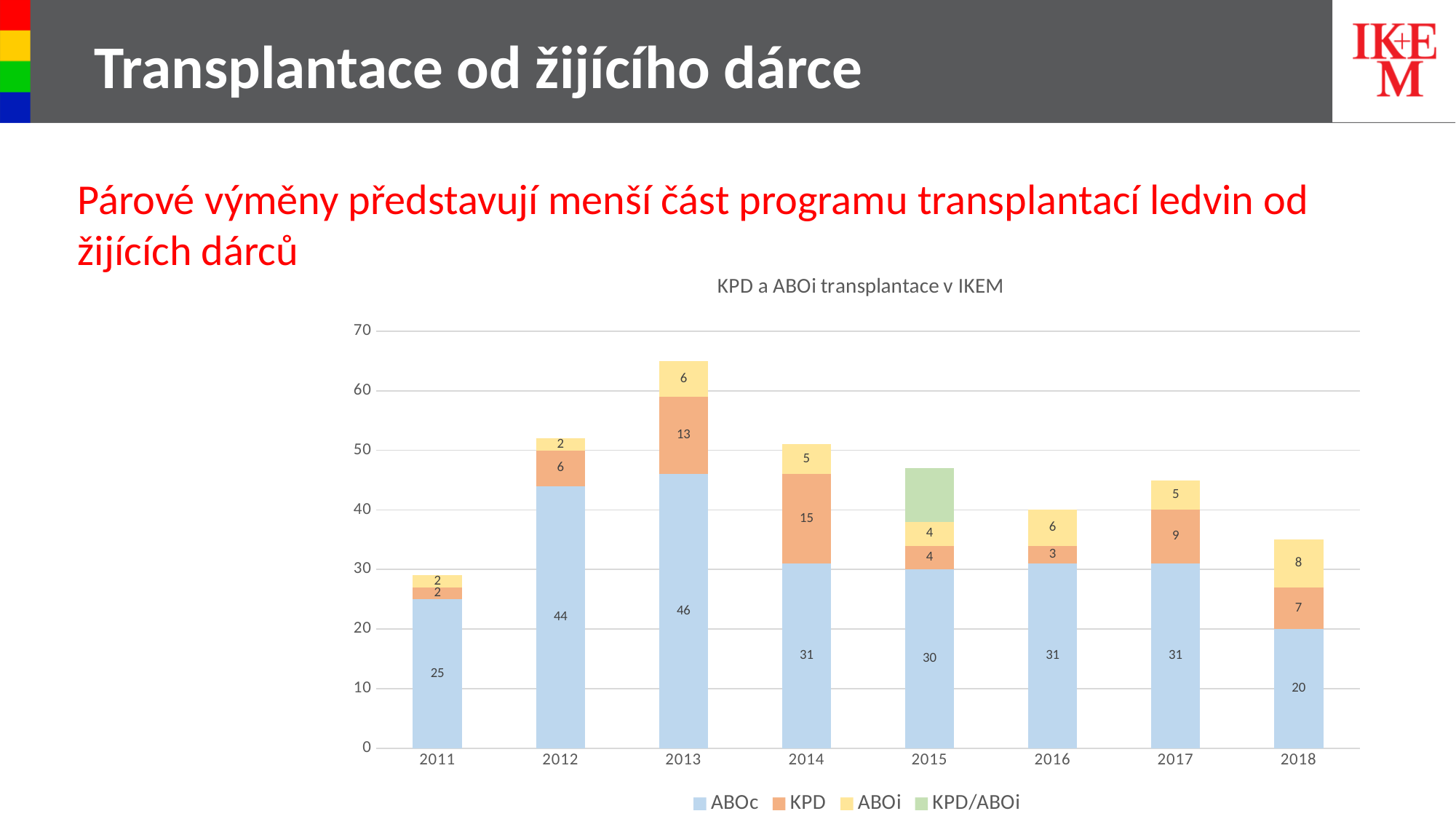
What is the difference between the KPD values for 2013 and 2012? 7 How many series does the legend list? 4 In which year is the ABOc value lowest? 2018 How many years are shown on the x axis? 8 Is the total height of the 2015 bar greater or less than 40? greater What is the ABOi value for 2018? 8 What type of chart is shown on the slide? stacked bar chart What is the total of the stacked bar for 2013? 65 What is the KPD value for 2014? 15 What is the ABOc value for 2013? 46 What is the title of the chart? KPD a ABOi transplantace v IKEM In which year is the ABOc value highest? 2013